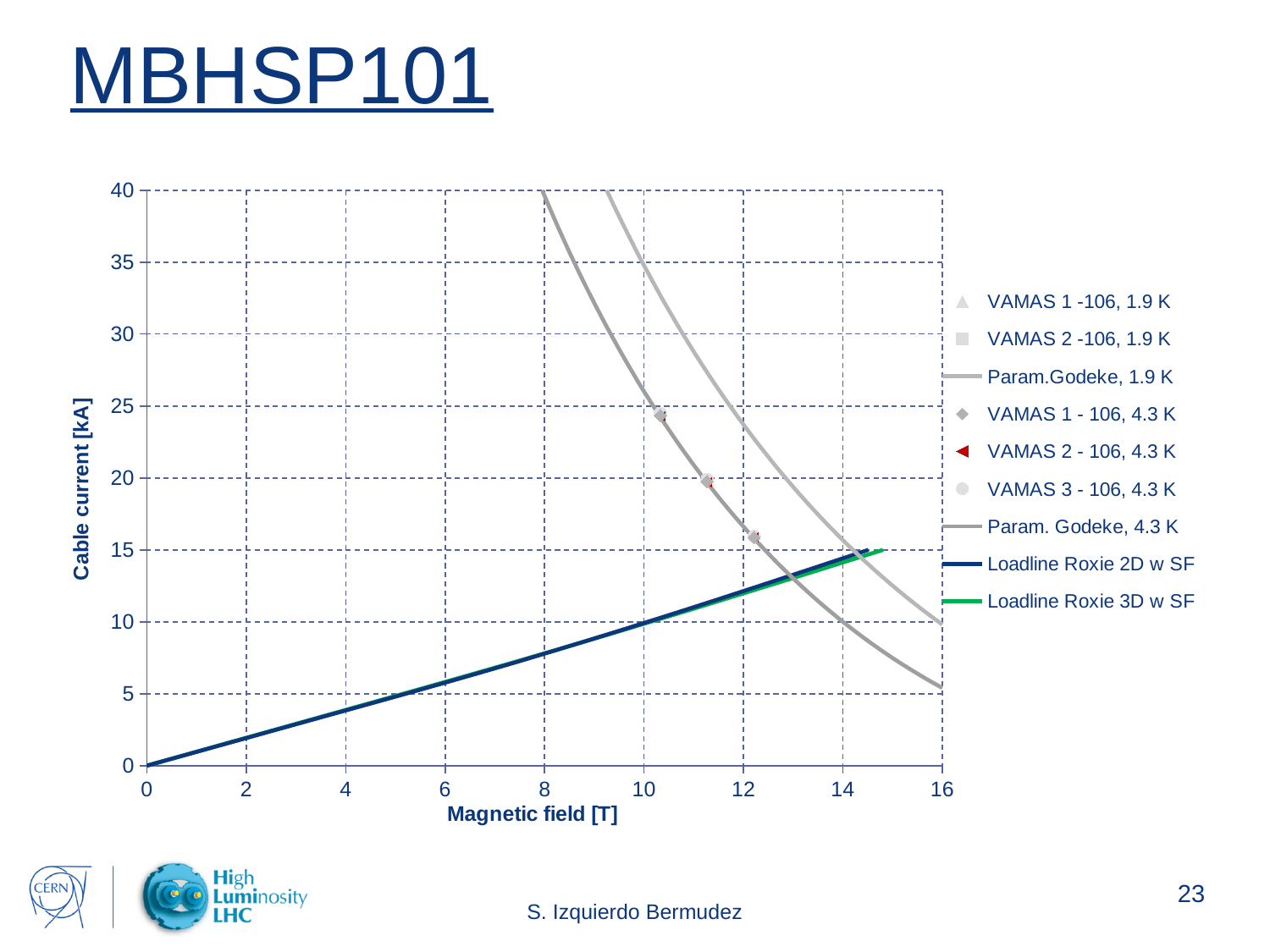
What is the label of the x axis? Magnetic field [T] At 10 T, which is higher: the Param. Godeke, 4.3 K curve or the Loadline Roxie 2D w SF? Param. Godeke, 4.3 K Does the Loadline Roxie 2D w SF series rise or fall as the magnetic field increases? rise Which legend entry is drawn in green? Loadline Roxie 3D w SF Is the cable current of the Loadline Roxie 2D w SF at 8 T greater or less than 10 kA? less Does the Param. Godeke, 4.3 K curve rise or fall as the magnetic field increases? fall How many series does the legend list? 9 At 12 T, which curve shows the higher cable current: Param.Godeke, 1.9 K or Param. Godeke, 4.3 K? Param.Godeke, 1.9 K Is the cable current of the Param.Godeke, 1.9 K curve at 12 T greater or less than 20 kA? greater Is the cable current of the Loadline Roxie 2D w SF at 12 T greater or less than 10 kA? greater What kind of chart is shown on the slide? line chart